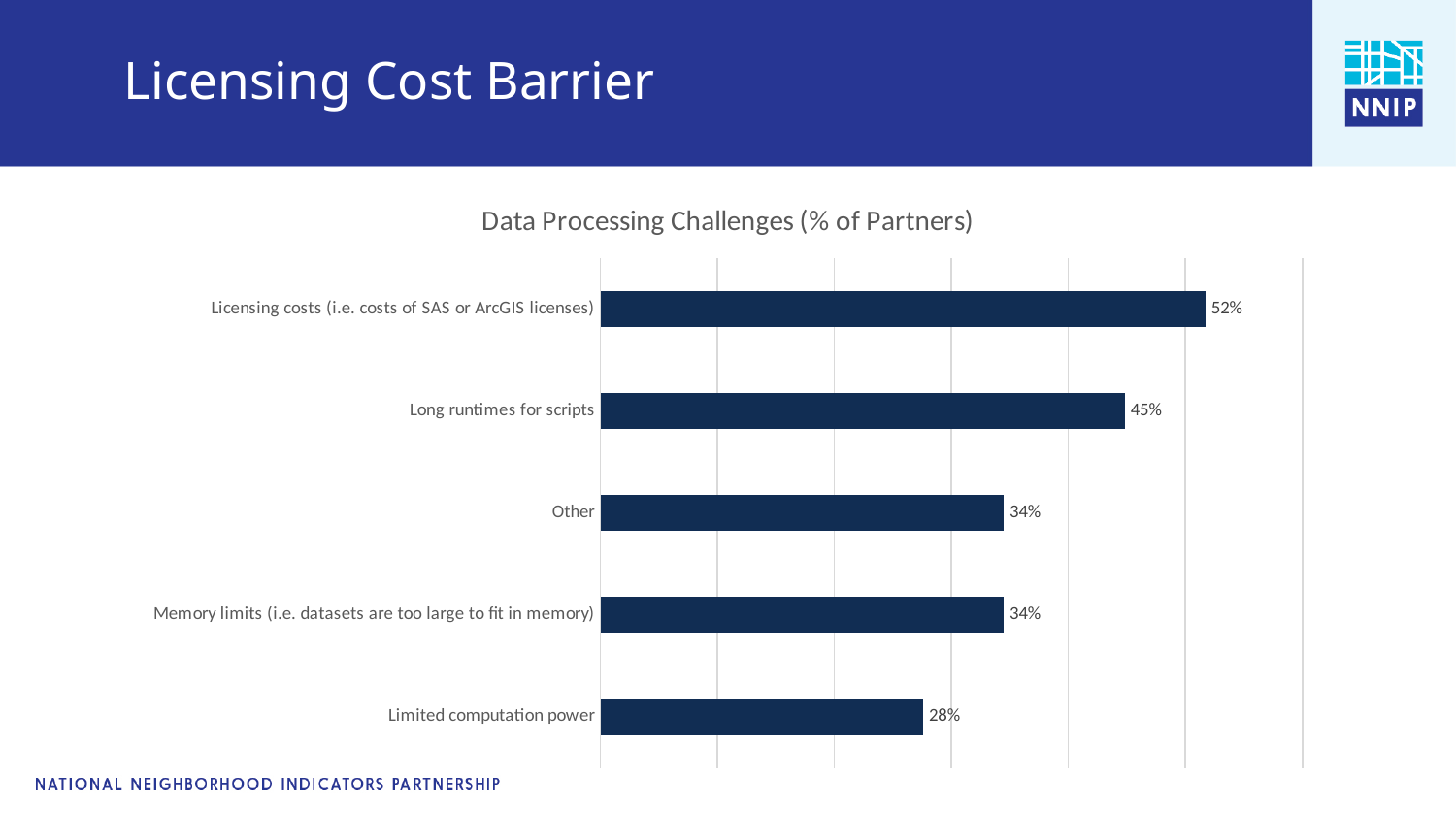
What kind of chart is shown on the slide? Bar chart Which is larger, the value for Long runtimes for scripts or the value for Memory limits? Long runtimes for scripts What is the difference in percentage points between Licensing costs and Long runtimes for scripts? 7 What is the value for Limited computation power? 28% What is the value for Long runtimes for scripts? 45% What is the difference in percentage points between Other and Limited computation power? 6 What percentage of partners reported licensing costs as a data processing challenge? 52% Which data processing challenge has the lowest percentage of partners? Limited computation power What is the value for Memory limits (i.e. datasets are too large to fit in memory)? 34% What is the title of the chart? Data Processing Challenges (% of Partners) How many data processing challenges are shown in the chart? 5 Which data processing challenge has the highest percentage of partners? Licensing costs (i.e. costs of SAS or ArcGIS licenses)